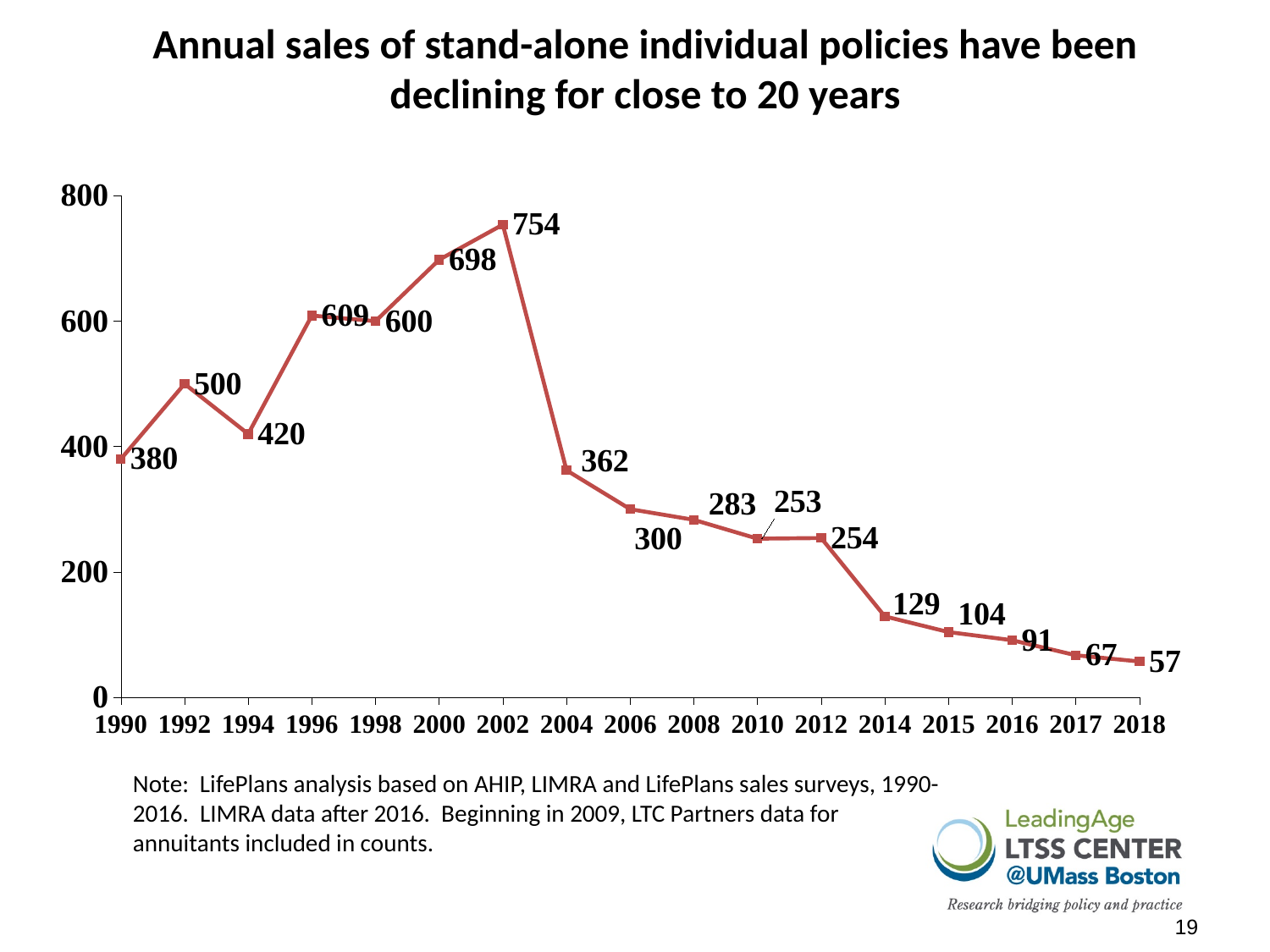
What was the value for 2014? 129 Do the values rise or fall from 2002 to 2018? fall Which year has the larger value, 1996 or 1998? 1996 Which year has the highest value? 2002 What was the value for 2002? 754 Which year has the lowest value? 2018 What is the difference between the values for 2002 and 2004? 392 What type of chart is shown on the slide? line chart What is the difference between the values for 2017 and 2018? 10 How many years are plotted on the x axis? 17 Is the value for 2006 greater or less than 400? less What was the value for 1990? 380